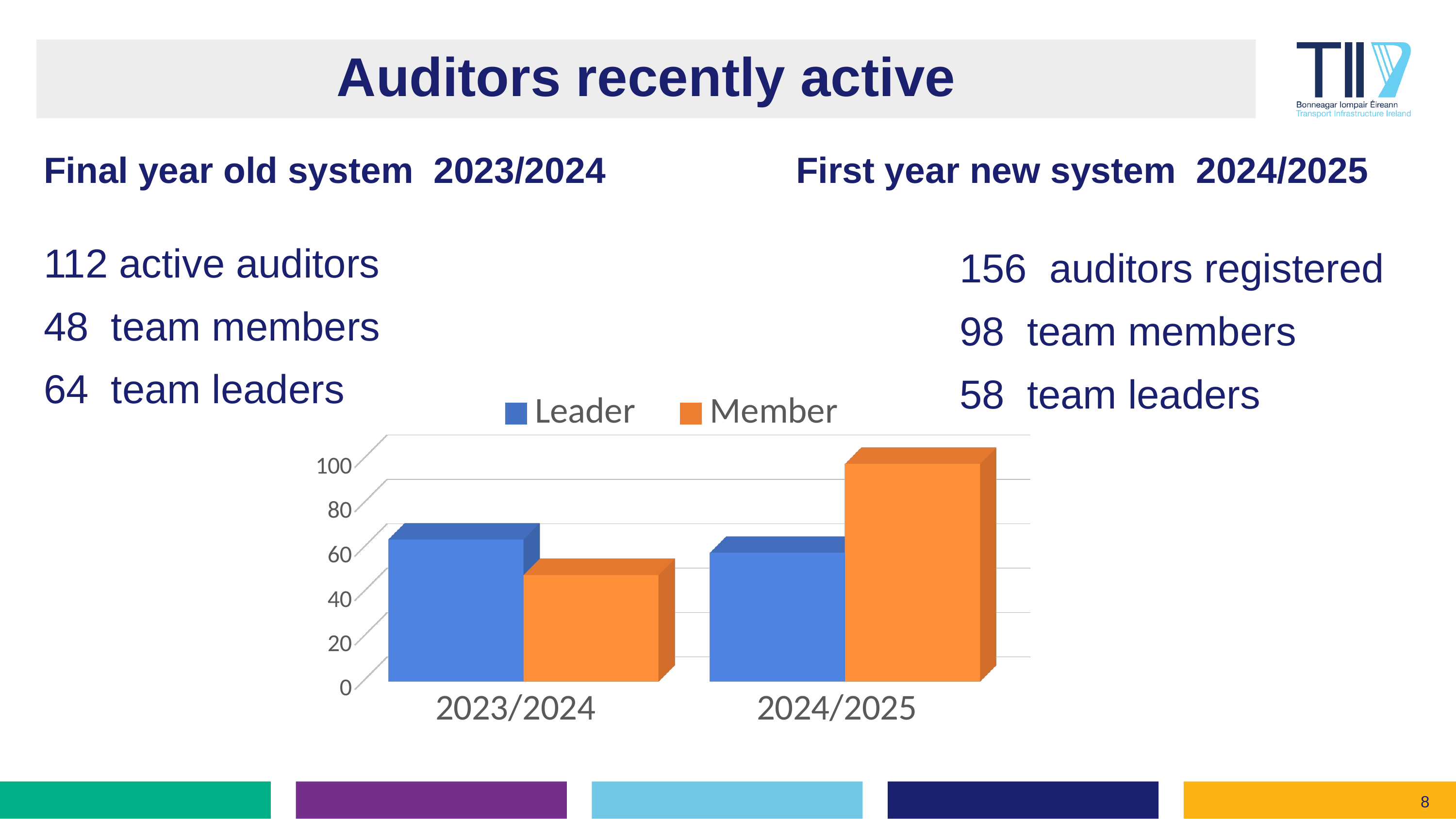
How many year categories are shown on the x axis of the chart? 2 What are the two series named in the chart legend? Leader and Member Is the Leader value for 2023/2024 greater or less than 60? greater Is the Member value for 2023/2024 greater or less than 60? less Which bar is the tallest in the chart? Member in 2024/2025 In 2024/2025, which is larger, the Leader bar or the Member bar? Member Is the Member value for 2024/2025 greater or less than 80? greater Which series is shown in orange in the chart? Member What kind of chart is shown on the slide? bar chart In 2023/2024, which is larger, the Leader bar or the Member bar? Leader How many series does the chart legend list? 2